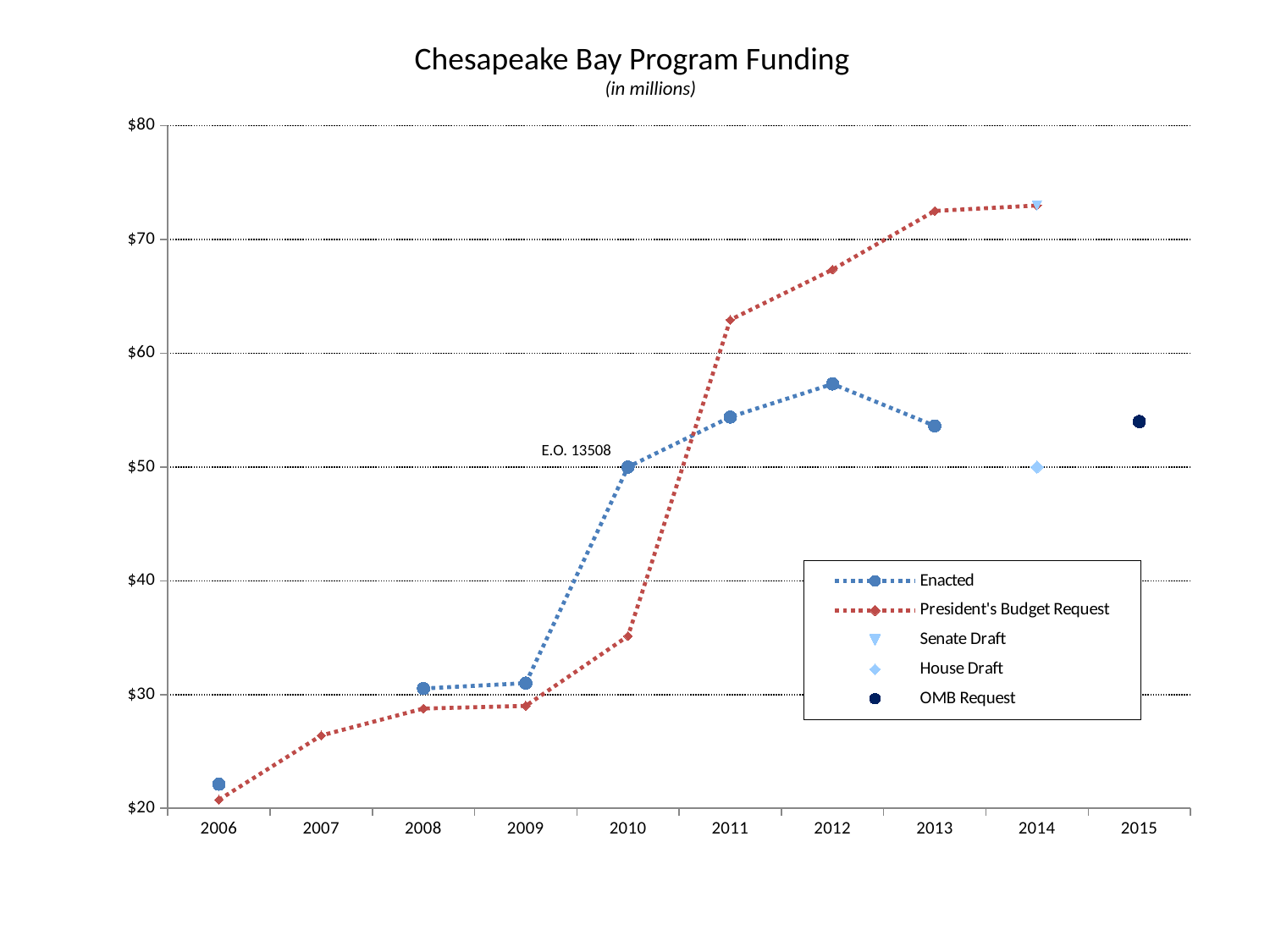
Does the President's Budget Request generally rise or fall from 2006 to 2014? rise Is the Senate Draft value for 2014 greater or less than $70? greater What kind of chart is shown on the slide? line chart Is the Enacted value for 2012 greater or less than $50? greater In 2008, which is larger: the Enacted value or the President's Budget Request value? Enacted In which year is the President's Budget Request value lowest? 2006 How many years are shown on the x axis? 10 In which year is the Enacted value highest? 2012 What annotation is printed next to the 2010 Enacted point? E.O. 13508 How many series does the legend list? 5 Is the President's Budget Request value for 2006 greater or less than $30? less In 2011, which is larger: the Enacted value or the President's Budget Request value? President's Budget Request